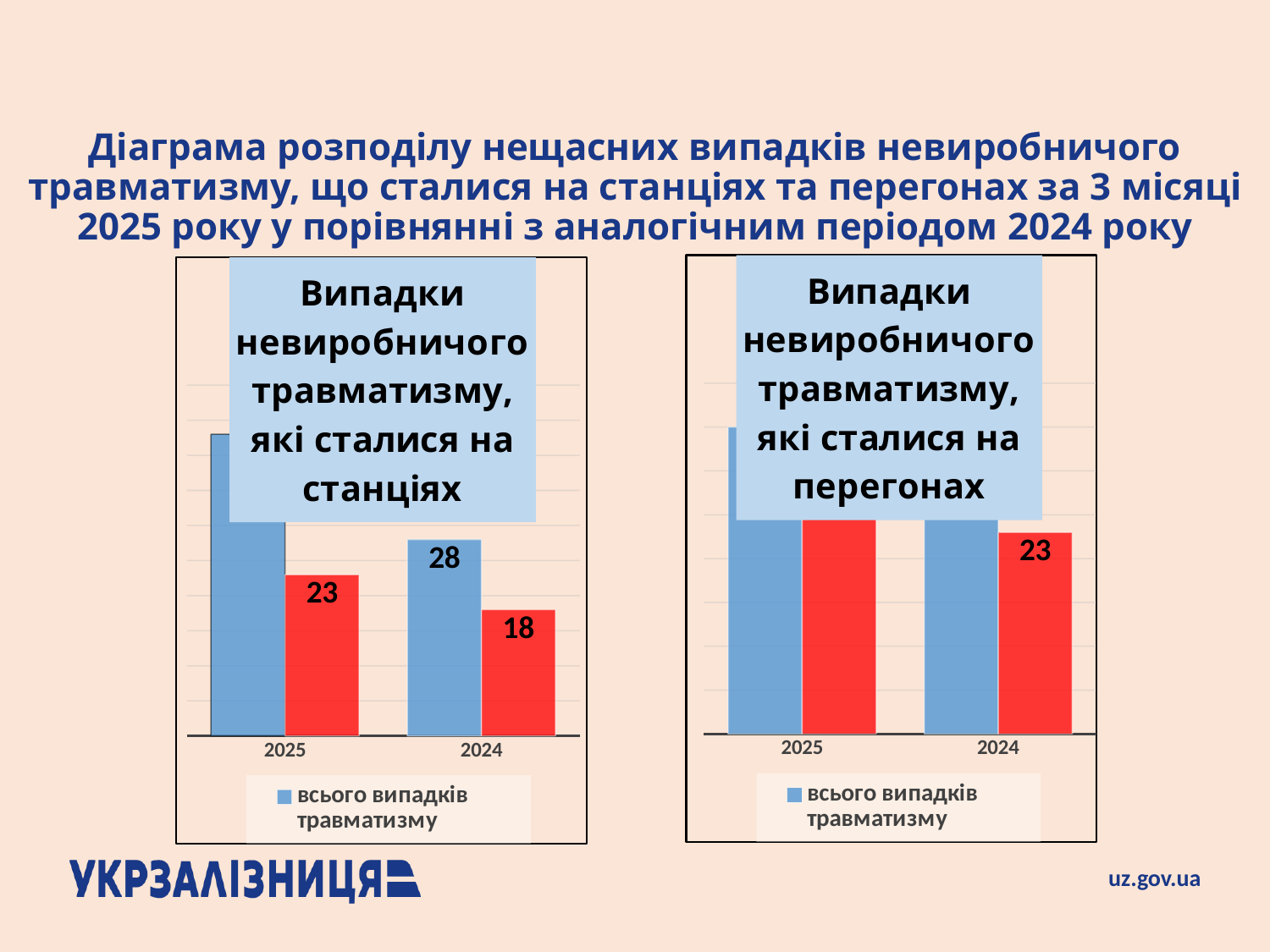
In the left chart (cases at stations), which year has the taller blue bar (всього випадків травматизму), 2025 or 2024? 2025 In the left chart (cases at stations), what is the difference between the blue bar and the red bar for 2024? 10 In the left chart (cases at stations), what is the value of the red bar for 2025? 23 In the left chart (cases at stations), which year has the higher red-bar value? 2025 In the right chart (cases on перегонах), what is the value of the red bar for 2024? 23 In the left chart (cases at stations), what is the value of the red bar for 2024? 18 How many year categories are shown on the x axis of the left chart (cases at stations)? 2 What type of chart is the right chart (cases on перегонах)? Bar chart In the left chart (cases at stations), by how much does the red bar for 2025 exceed the red bar for 2024? 5 What legend entry is shown for the blue bars in the left chart (cases at stations)? всього випадків травматизму In the left chart (cases at stations), what is the value of the blue bar (всього випадків травматизму) for 2024? 28 In the right chart (cases on перегонах), which year has the taller blue bar (всього випадків травматизму), 2025 or 2024? 2025